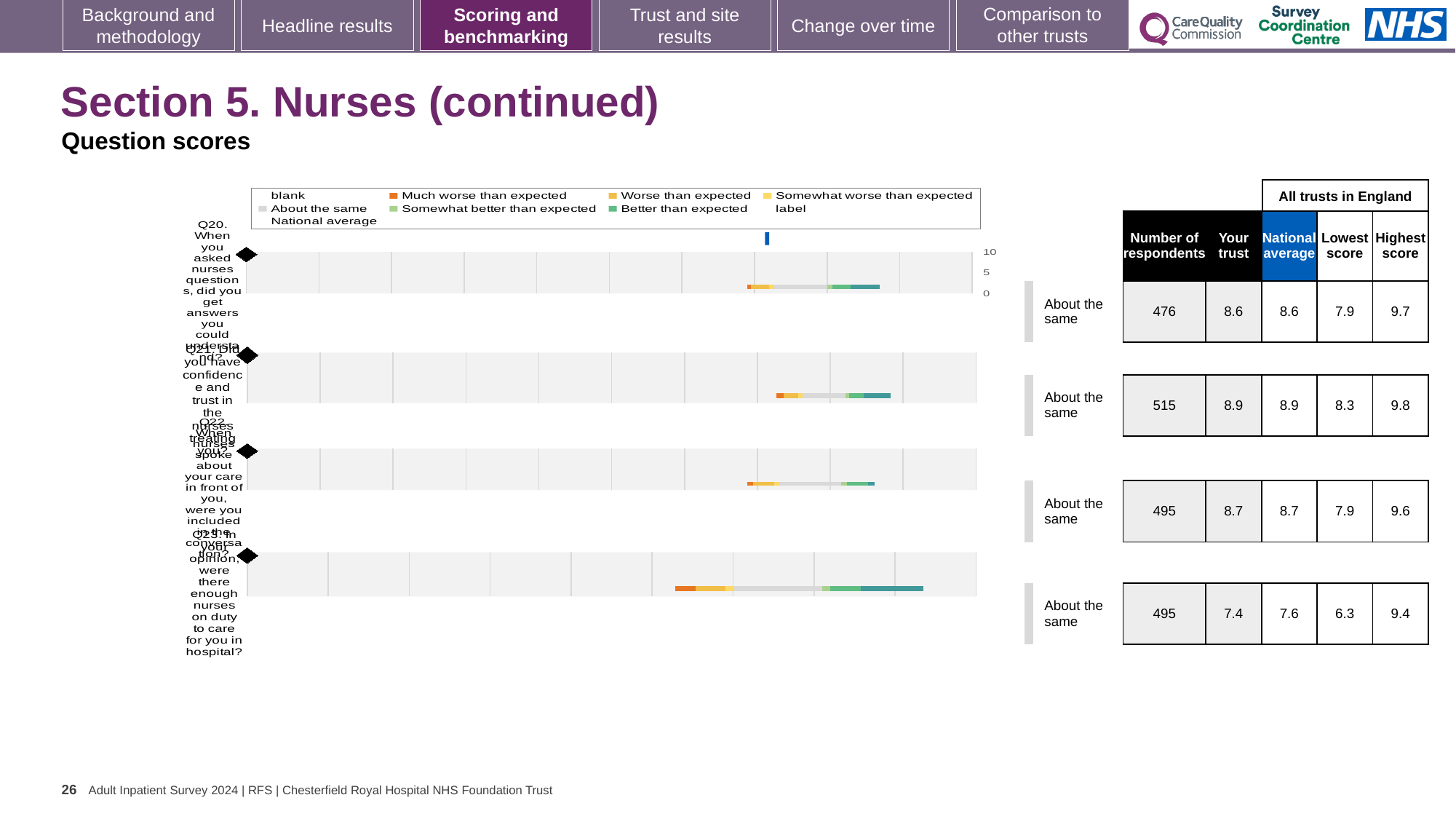
Which question has the highest 'Your trust' score? Q21 What is the difference between the highest score and the lowest score for Q20? 1.8 What is the national average for Q23 (enough nurses on duty)? 7.6 What is the lowest score among all trusts in England for Q23? 6.3 Which question has the lowest 'Your trust' score? Q23 What is the highest score among all trusts in England for Q21? 9.8 What kind of chart is used to show the question scores for Q20 to Q23? bar chart What is the 'Your trust' score for Q21 (confidence and trust in the nurses)? 8.9 What benchmark category is shown for Q23 (enough nurses on duty)? About the same What is the 'Your trust' score for Q23 (enough nurses on duty)? 7.4 How many questions (Q20 to Q23) are plotted in the chart? 4 Is the 'Your trust' score for Q22 larger or smaller than the 'Your trust' score for Q23? larger